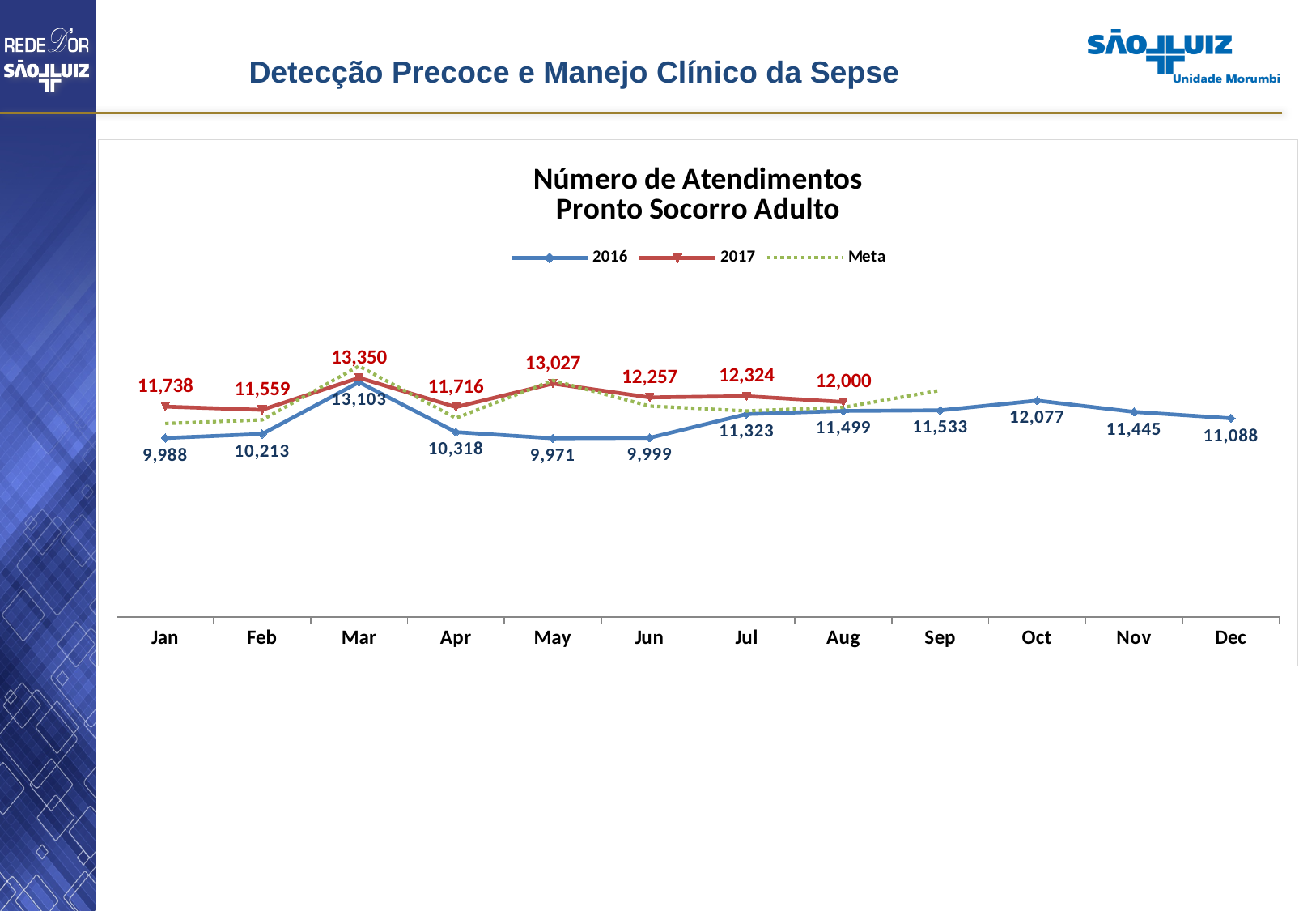
What kind of chart is shown on the slide? line chart What is the value for 2016 in October? 12,077 How many months are shown on the x axis? 12 In which month is the 2016 value lowest? May Through which month does the 2017 series have data labels? Aug In which month is the 2017 value highest? Mar What is the difference between the 2017 and 2016 values in January? 1,750 What is the title of the chart? Número de Atendimentos Pronto Socorro Adulto Which is larger in August, the 2016 value or the 2017 value? 2017 What is the value for 2017 in May? 13,027 What is the value for 2016 in March? 13,103 How many series does the legend list? 3